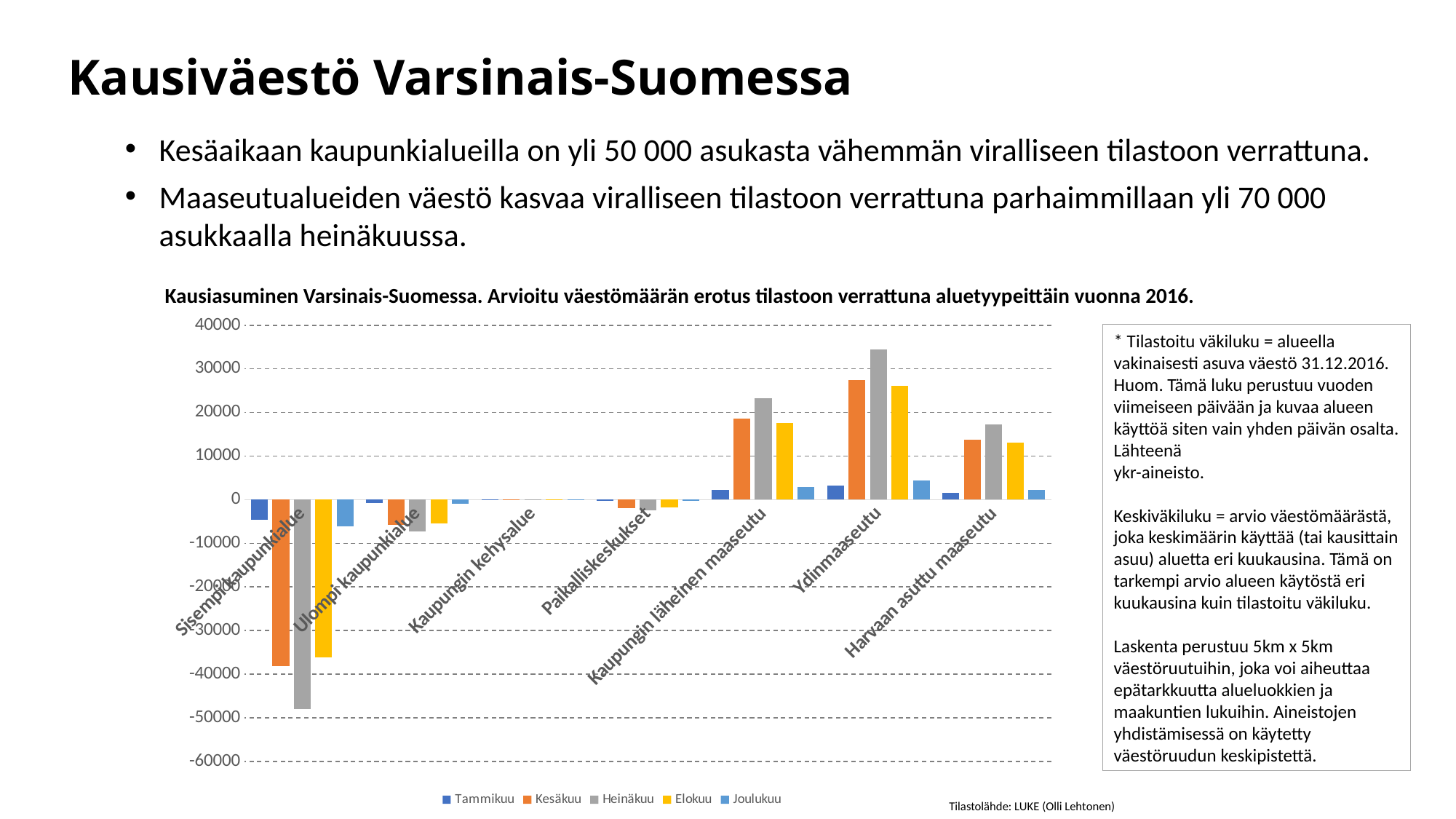
How many area-type categories are shown on the x axis of the chart? 7 Is the Heinäkuu value for Ydinmaaseutu greater or less than 30000? greater Is the Elokuu value for Sisempi kaupunkialue greater or less than -30000? less Which category has the lowest Heinäkuu value in the chart? Sisempi kaupunkialue Which series in the chart's legend is shown in grey? Heinäkuu Is the Heinäkuu value for Sisempi kaupunkialue greater or less than -40000? less What kind of chart is shown on the slide? bar chart Which category has the highest Heinäkuu value in the chart? Ydinmaaseutu Which is larger: the Heinäkuu value for Ydinmaaseutu or the Heinäkuu value for Harvaan asuttu maaseutu? Ydinmaaseutu How many series does the chart's legend list? 5